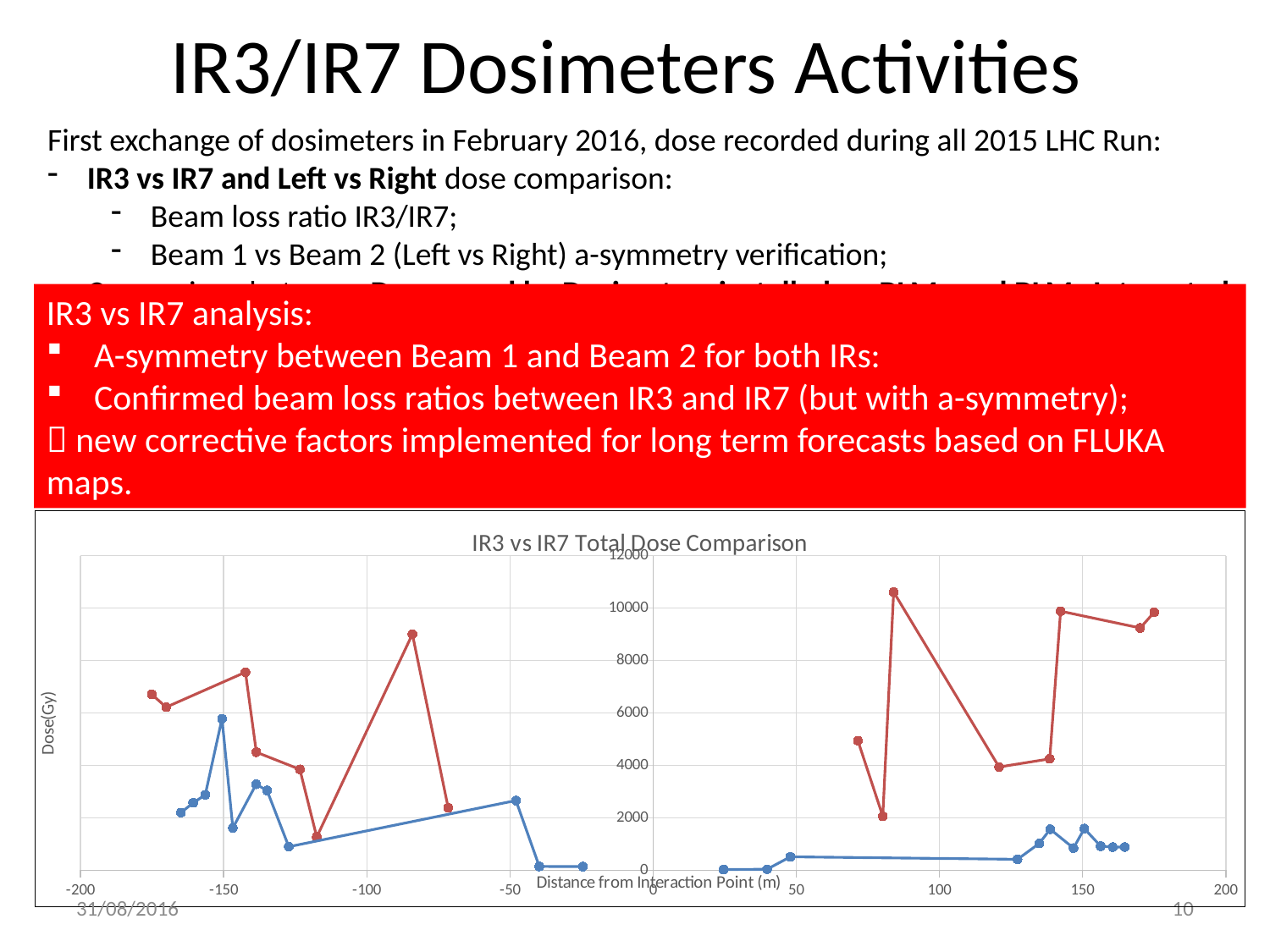
Which series has the lowest values on the chart, the red one or the blue one? Blue What is the maximum value shown on the vertical axis of the chart? 12000 Is the highest value of the blue series greater or less than 8000? less What is the label of the vertical axis of the chart? Dose(Gy) Are the blue series values on the right-hand side of the chart (positive distances) greater or less than 2000? less Is the value of the red series at about -85 m greater or less than 8000? greater What kind of chart is shown on the slide? Line chart Which series reaches the highest dose value on the chart, the red one or the blue one? Red What is the title of the chart? IR3 vs IR7 Total Dose Comparison